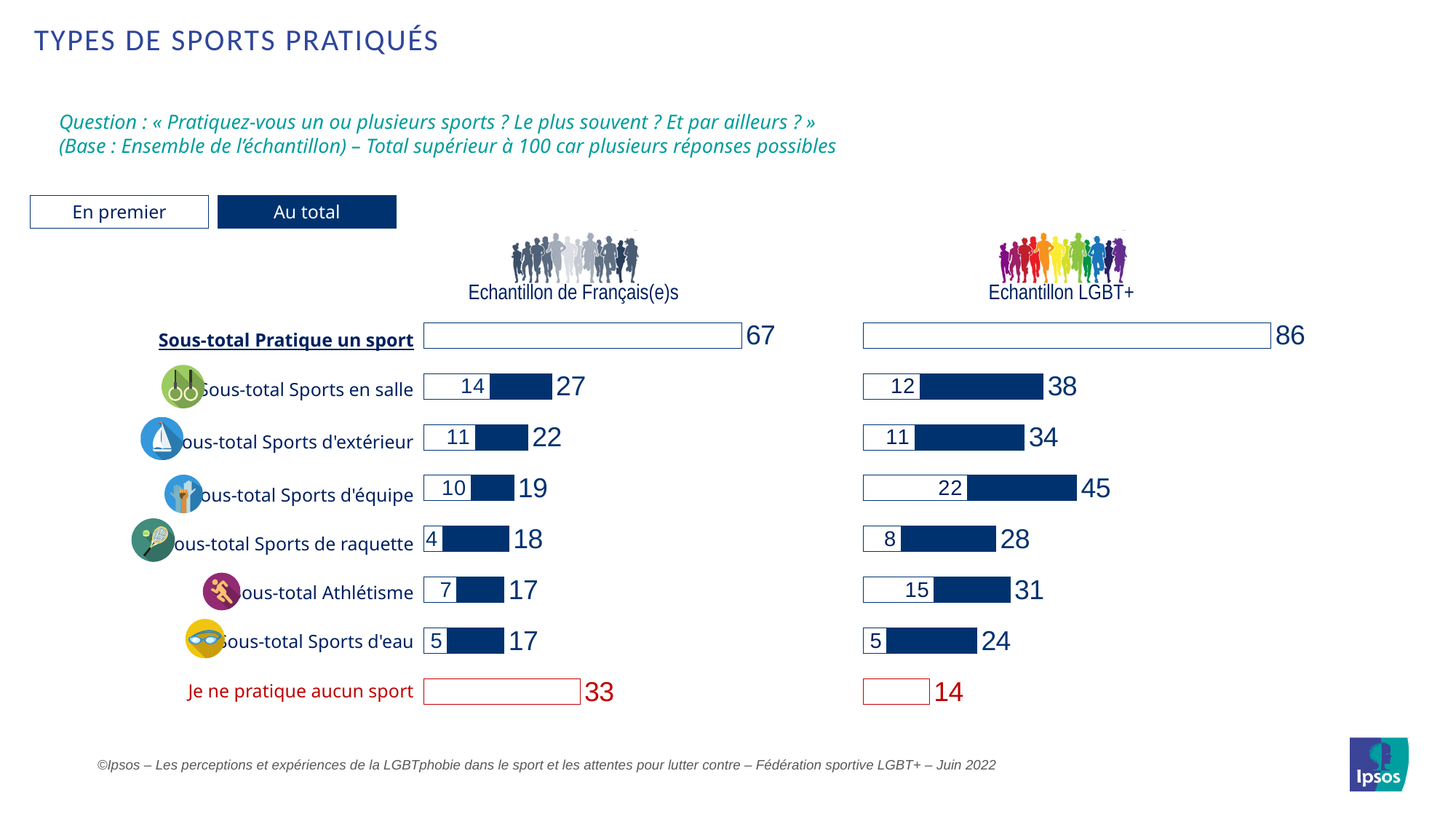
In the 'Echantillon de Français(e)s' chart, what is the value for Je ne pratique aucun sport? 33 In the 'Echantillon LGBT+' chart, which sport category (excluding the overall sub-total) has the highest 'Au total' value? Sous-total Sports d'équipe How many categories are shown in the 'Echantillon LGBT+' chart? 8 In the 'Echantillon de Français(e)s' chart, which sport category has the lowest 'En premier' value? Sous-total Sports de raquette In the 'Echantillon de Français(e)s' chart, what is the difference between the 'Au total' and 'En premier' values for Sous-total Athlétisme? 10 What is the difference between the 'Au total' values for Sous-total Sports d'extérieur in the 'Echantillon LGBT+' chart and the 'Echantillon de Français(e)s' chart? 12 In the 'Echantillon LGBT+' chart, what is the 'En premier' value for Sous-total Sports d'équipe? 22 What type of chart is used on this slide? Bar chart Which is larger: the 'Je ne pratique aucun sport' value in the 'Echantillon de Français(e)s' chart or in the 'Echantillon LGBT+' chart? Echantillon de Français(e)s In the 'Echantillon de Français(e)s' chart, what is the 'Au total' value for Sous-total Sports en salle? 27 How many series does the legend list? 2 In the 'Echantillon LGBT+' chart, what is the value for Sous-total Pratique un sport? 86